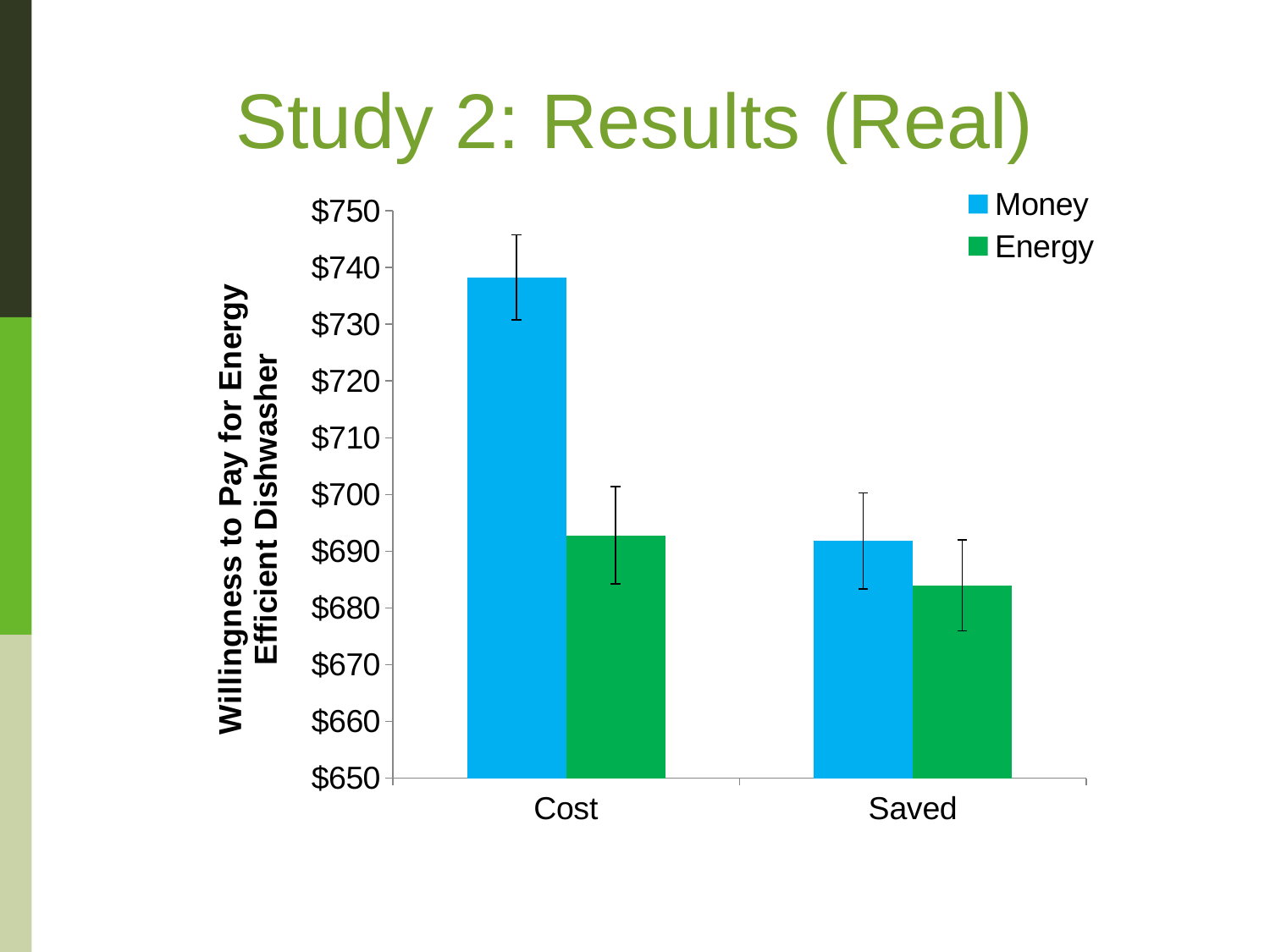
What is the title of the vertical axis? Willingness to Pay for Energy Efficient Dishwasher For the Cost category, which series has the larger value, Money or Energy? Money Is the Money value for Saved greater or less than $700? less Is the Energy value for Saved greater or less than $690? less Is the Money value for Cost greater or less than $730? greater What kind of chart is shown on the slide? bar chart Which bar is the lowest in the chart? Energy for Saved How many series does the legend list? 2 Does the Money series rise or fall from Cost to Saved? fall Which bar is the highest in the chart? Money for Cost How many categories are shown on the x axis? 2